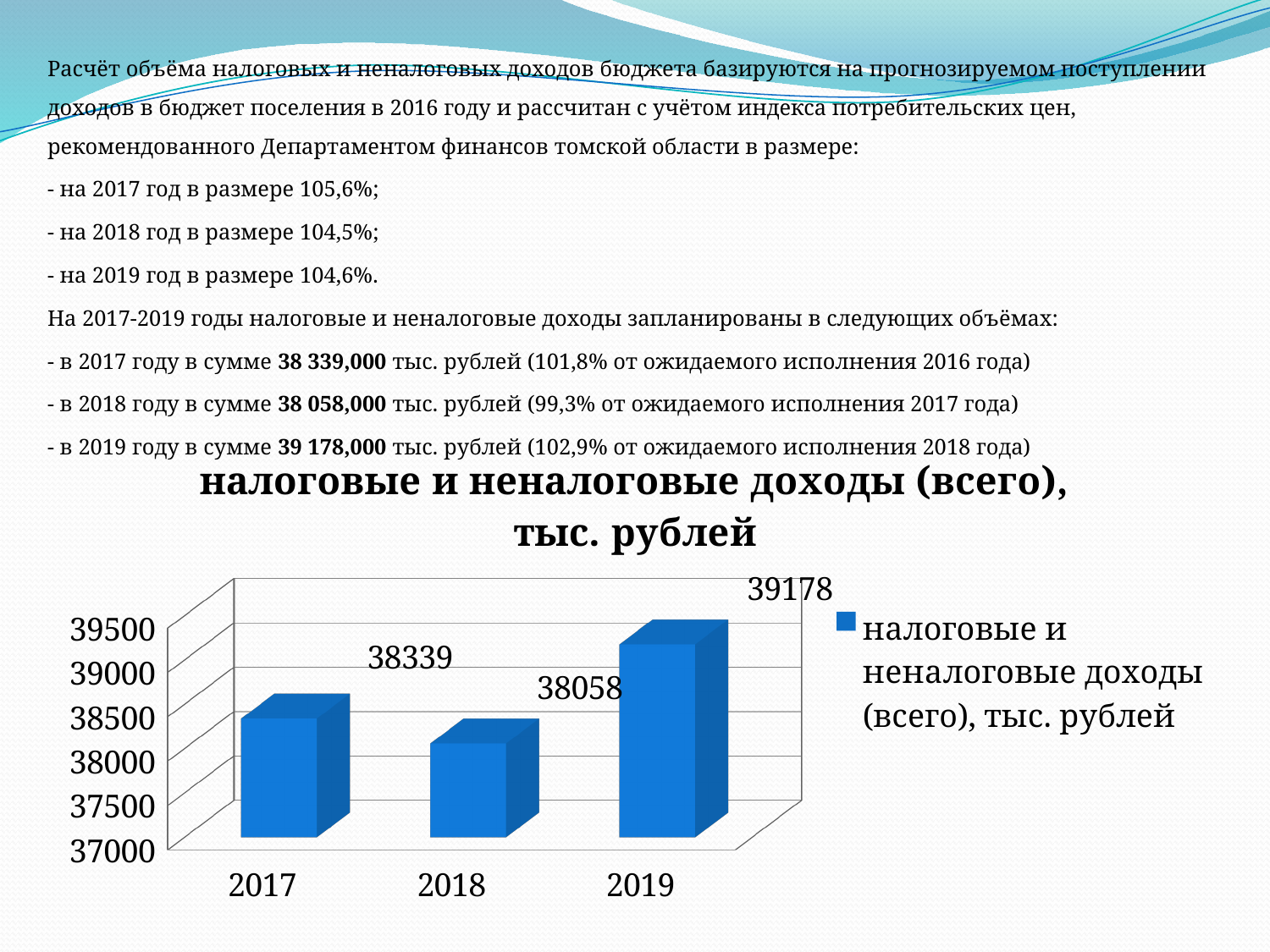
What is the value for 2019 in the chart? 39178 How many years are shown on the x axis of the chart? 3 What is the title of the chart? налоговые и неналоговые доходы (всего), тыс. рублей What is the value for 2018 in the chart? 38058 What is the difference between the values for 2019 and 2018? 1120 What is the value for 2017 in the chart? 38339 Which year has the highest value in the chart? 2019 What is the difference between the values for 2017 and 2018? 281 Which is larger, the value for 2017 or the value for 2019? 2019 Which year has the lowest value in the chart? 2018 Is the value for 2018 greater or less than 38500? less What kind of chart is shown on the slide? bar chart